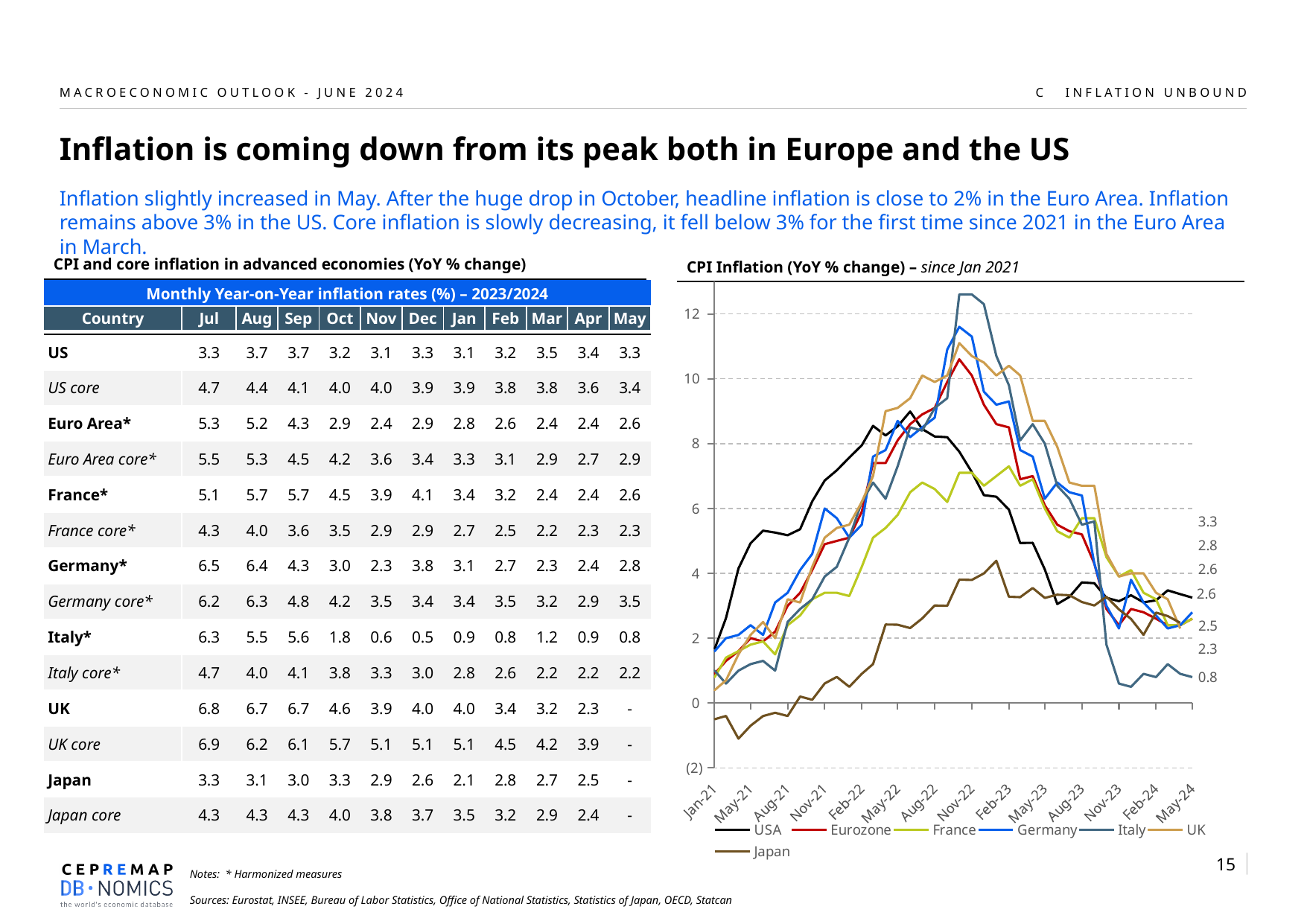
In the CPI Inflation chart, what is the end-of-period value labelled for the lowest line (Italy)? 0.8 In the CPI Inflation chart, which colour is used for the USA series? black In the CPI Inflation chart, is the peak value for Japan greater or less than 6? less In the CPI Inflation chart, which series is lower at the start of the period (Jan-21): Japan or USA? Japan In the CPI Inflation chart, which series has the lowest value at the end of the period (May-24)? Italy In the CPI Inflation chart, is the peak value for Italy greater or less than 12? greater How many series does the legend of the CPI Inflation chart list? 7 In the CPI Inflation chart, does the Italy line rise or fall between Nov-22 and May-24? fall In the CPI Inflation chart, what is the end-of-period value labelled for the highest line (USA)? 3.3 In the CPI Inflation chart, which series reaches the highest peak? Italy In the CPI Inflation chart, is the value for Japan in Jan-21 greater or less than 0? less What kind of chart is the 'CPI Inflation (YoY % change) – since Jan 2021' chart? line chart